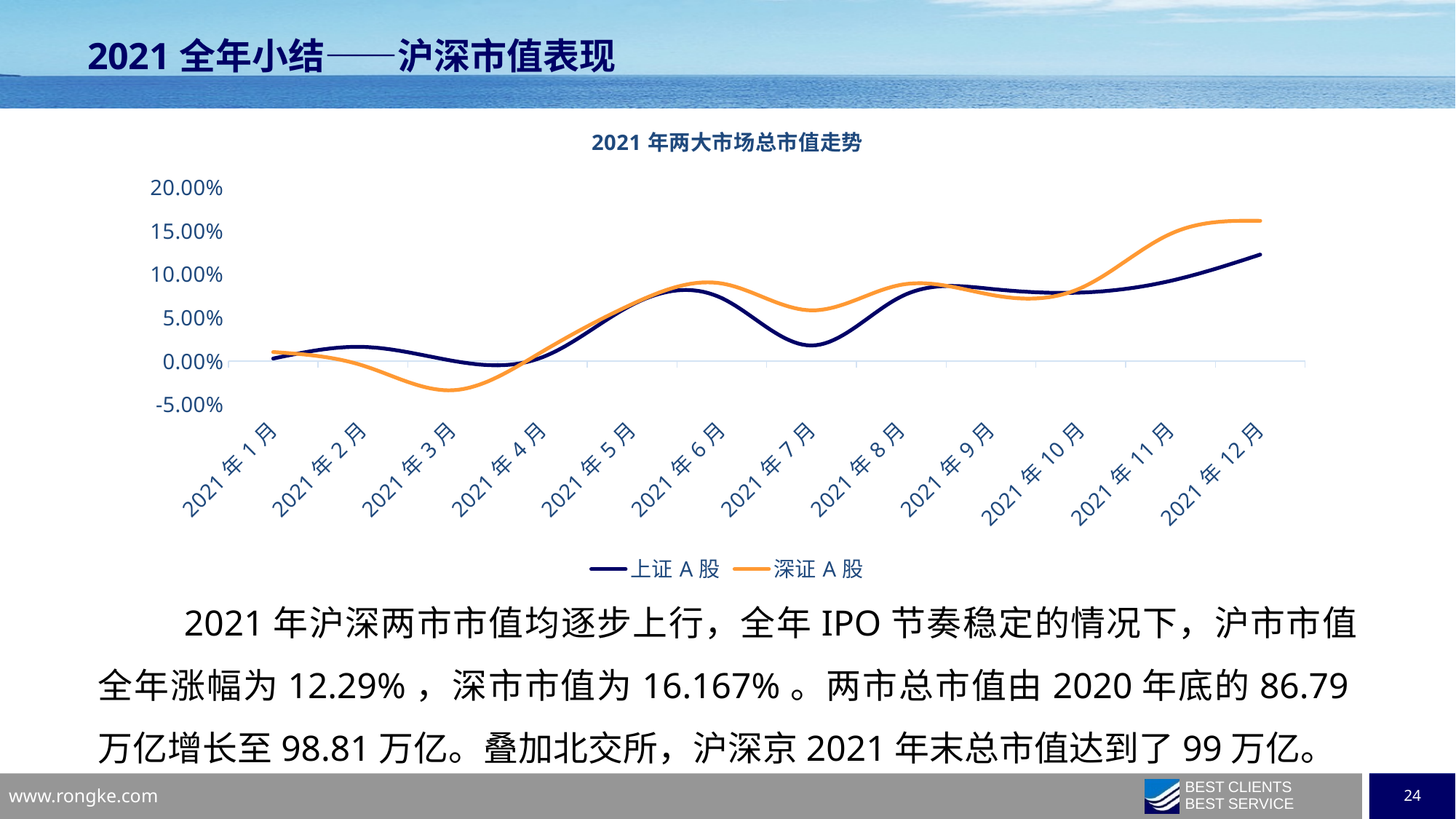
In 2021 年 3 月, which series has the higher value, 上证 A 股 or 深证 A 股? 上证 A 股 Which series is drawn in orange? 深证 A 股 Is the value for 上证 A 股 in 2021 年 7 月 greater or less than 5.00%? less In 2021 年 12 月, which series has the higher value, 上证 A 股 or 深证 A 股? 深证 A 股 What kind of chart is shown on the slide? line chart What is the title of the chart? 2021 年两大市场总市值走势 Is the value for 深证 A 股 in 2021 年 3 月 greater or less than 0.00%? less How many series does the legend list? 2 Is the value for 深证 A 股 in 2021 年 12 月 greater or less than 15.00%? greater How many months are plotted along the x axis? 12 In which month does 深证 A 股 reach its lowest value? 2021 年 3 月